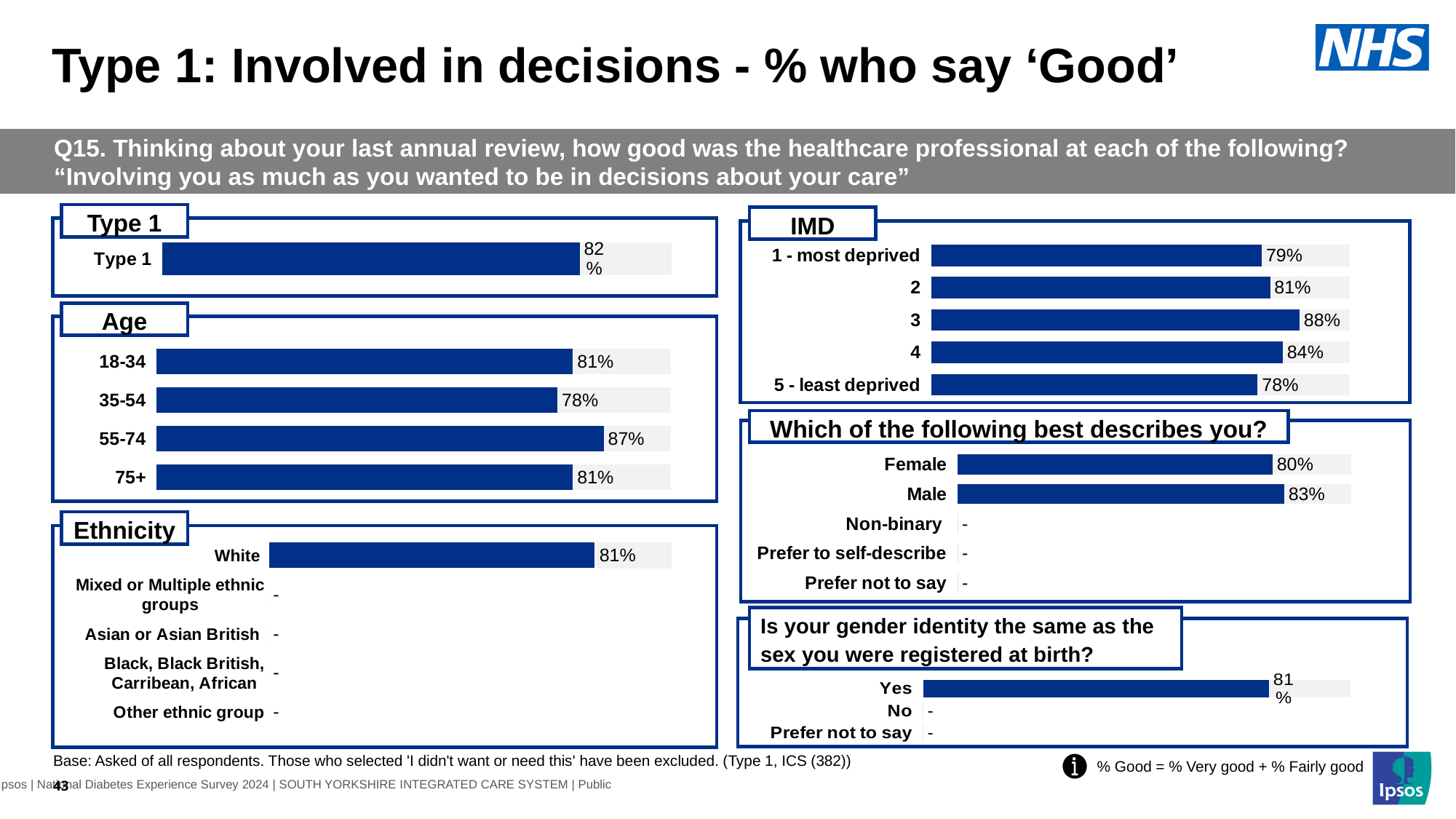
In the Age chart, what is the value for 55-74? 87% What type of chart is used in the Age section? Bar chart In the Age chart, which age group has the lowest value? 35-54 In the IMD chart, what is the value for 5 - least deprived? 78% In the Ethnicity chart, what is the value for White? 81% In the Age chart, what is the difference between the values for 55-74 and 35-54? 9 percentage points In the IMD chart, how many categories are shown? 5 In the IMD chart, which category has the highest value? 3 In the 'Which of the following best describes you?' chart, which is larger, Female or Male? Male In the 'Is your gender identity the same as the sex you were registered at birth?' chart, what is the value for Yes? 81% In the Type 1 chart, what is the value for Type 1? 82% In the 'Which of the following best describes you?' chart, what is the difference between Male and Female? 3 percentage points